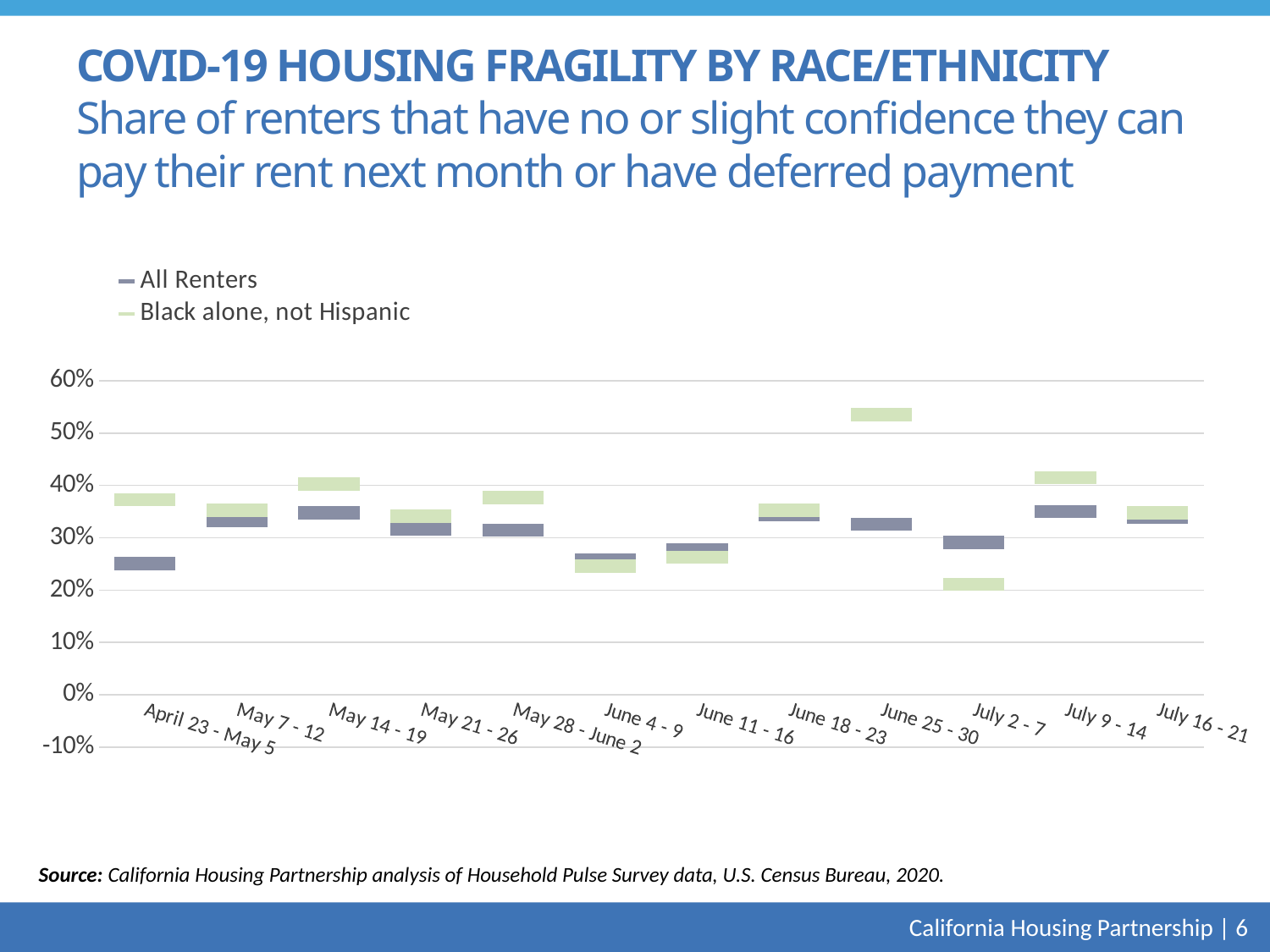
Is the value for All Renters in April 23 - May 5 greater or less than 30%? less In July 2 - 7, which series has the larger value, All Renters or Black alone, not Hispanic? All Renters How many survey periods are shown on the x axis of the chart? 12 What are the two series named in the chart's legend? All Renters; Black alone, not Hispanic In April 23 - May 5, which series has the larger value, All Renters or Black alone, not Hispanic? Black alone, not Hispanic How many series does the chart's legend list? 2 In June 25 - 30, which series has the larger value, All Renters or Black alone, not Hispanic? Black alone, not Hispanic Is the value for Black alone, not Hispanic in July 2 - 7 greater or less than 30%? less Is the value for Black alone, not Hispanic in June 25 - 30 greater or less than 50%? greater Which survey period has the highest value for Black alone, not Hispanic? June 25 - 30 Which survey period has the lowest value for Black alone, not Hispanic? July 2 - 7